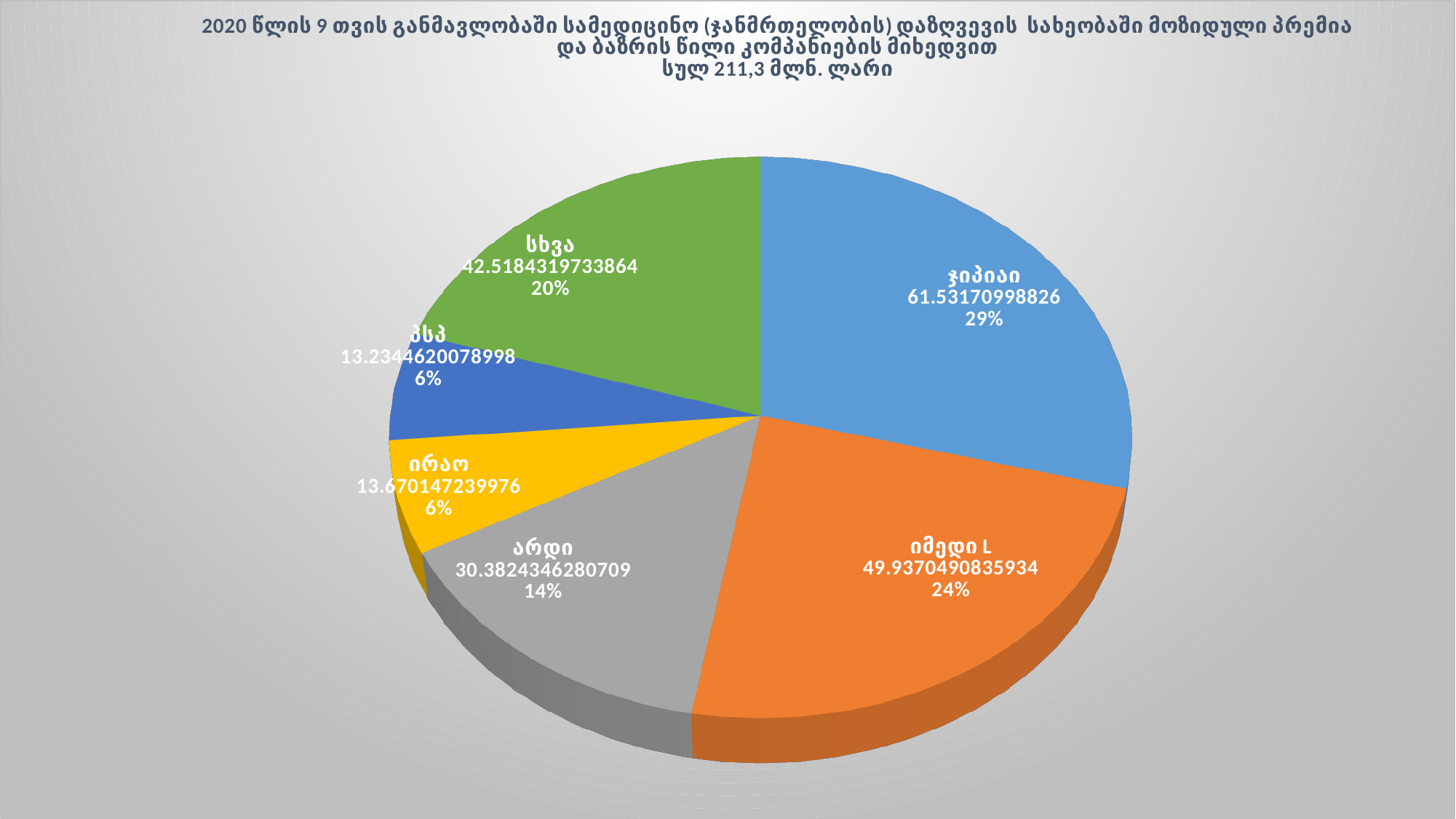
Which slice has the largest value? ჯიპიაი What is the value shown for არდი? 30.3824346280709 What percentage share does სხვა have? 20% What percentage share does პსპ have? 6% How many slices does the pie chart have? 6 What is the value shown for ირაო? 13.670147239976 What kind of chart is shown on the slide? pie chart What total amount is stated in the chart title? 211,3 მლნ. ლარი Which slice has the smallest value? პსპ Which is larger, the value for იმედი L or the value for სხვა? იმედი L What percentage share does იმედი L have? 24% What is the value shown for ჯიპიაი? 61.53170998826